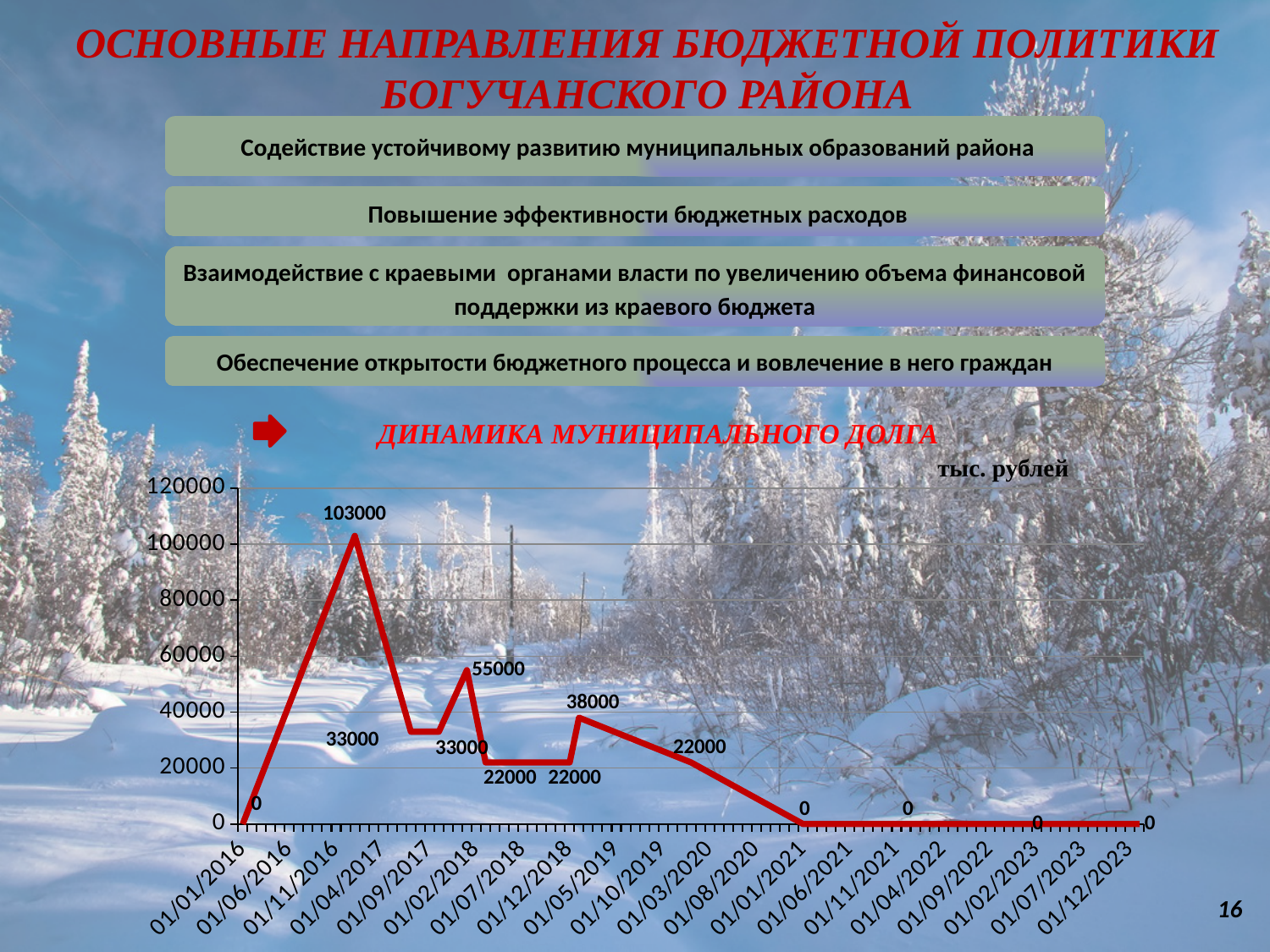
What is the value of municipal debt at 01/12/2023? 0 How many data labels on the line show a value of 0? 5 Does the line rise or fall between 01/05/2019 and 01/01/2021? falls What kind of chart is shown on the slide? line chart In what units are the chart values given? тыс. рублей Is the peak value of the line greater or less than 100000? greater What is the highest value labelled on the line? 103000 What is the difference between the highest labelled value (103000) and the labelled value 55000? 48000 What is the difference between the labelled values 38000 and 22000? 16000 Is the value at 01/01/2021 greater or less than 20000? less What is the title of the chart? ДИНАМИКА МУНИЦИПАЛЬНОГО ДОЛГА What is the value of municipal debt at 01/01/2016? 0